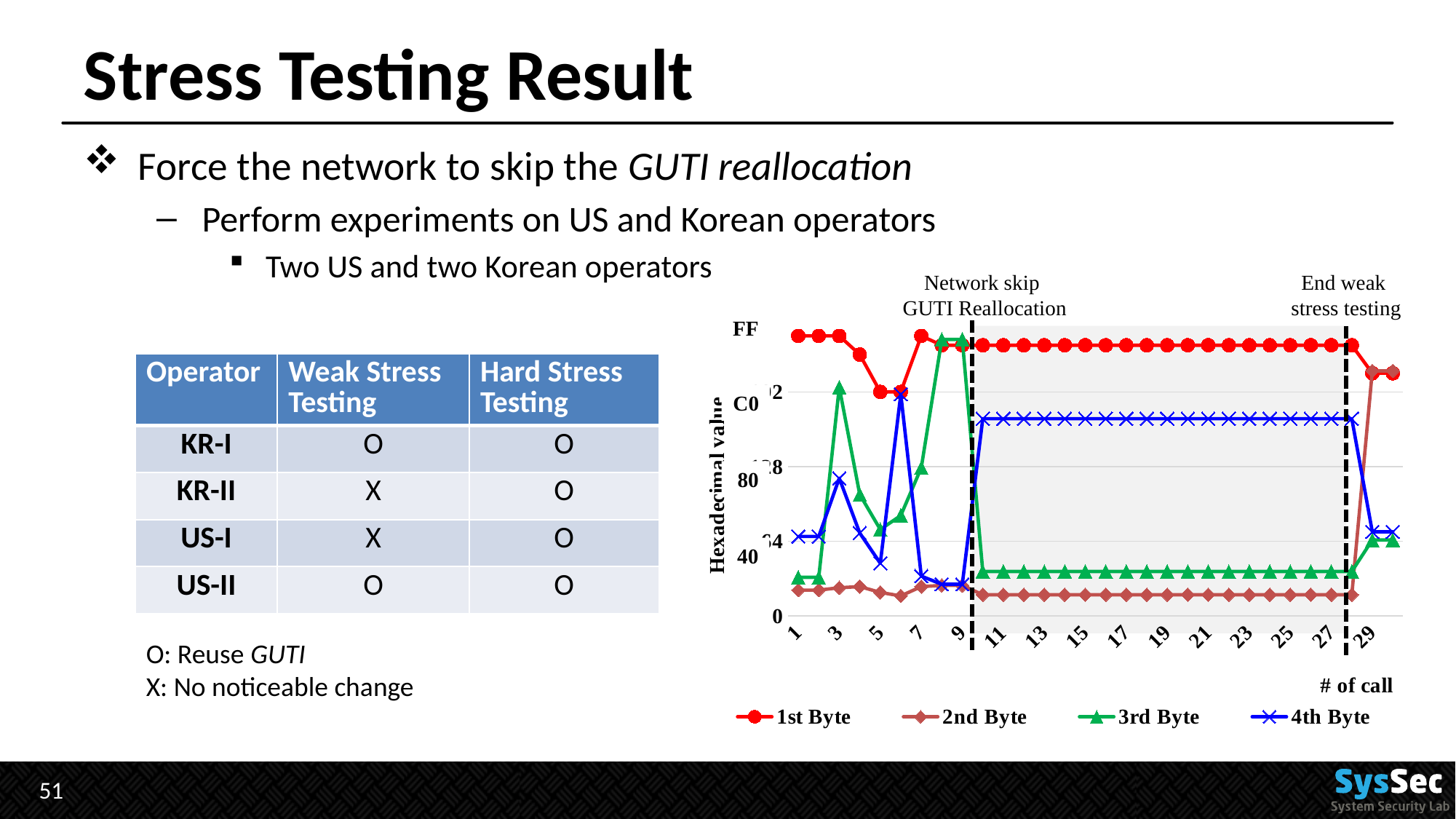
Is the value of 1st Byte at call 15 greater or less than C0? greater How many series does the chart legend list? 4 Which series has the lowest value at call 19? 2nd Byte Is the value of 3rd Byte at call 21 greater or less than 80? less Is the value of 2nd Byte at call 15 greater or less than 40? less What are the series names listed in the chart legend? 1st Byte, 2nd Byte, 3rd Byte, 4th Byte At call 21, which series has the larger value, 4th Byte or 3rd Byte? 4th Byte What is the x-axis title of the chart? # of call At call 15, which series has the larger value, 1st Byte or 2nd Byte? 1st Byte What kind of chart is shown on the slide? line chart Which series has the highest value at call 19? 1st Byte